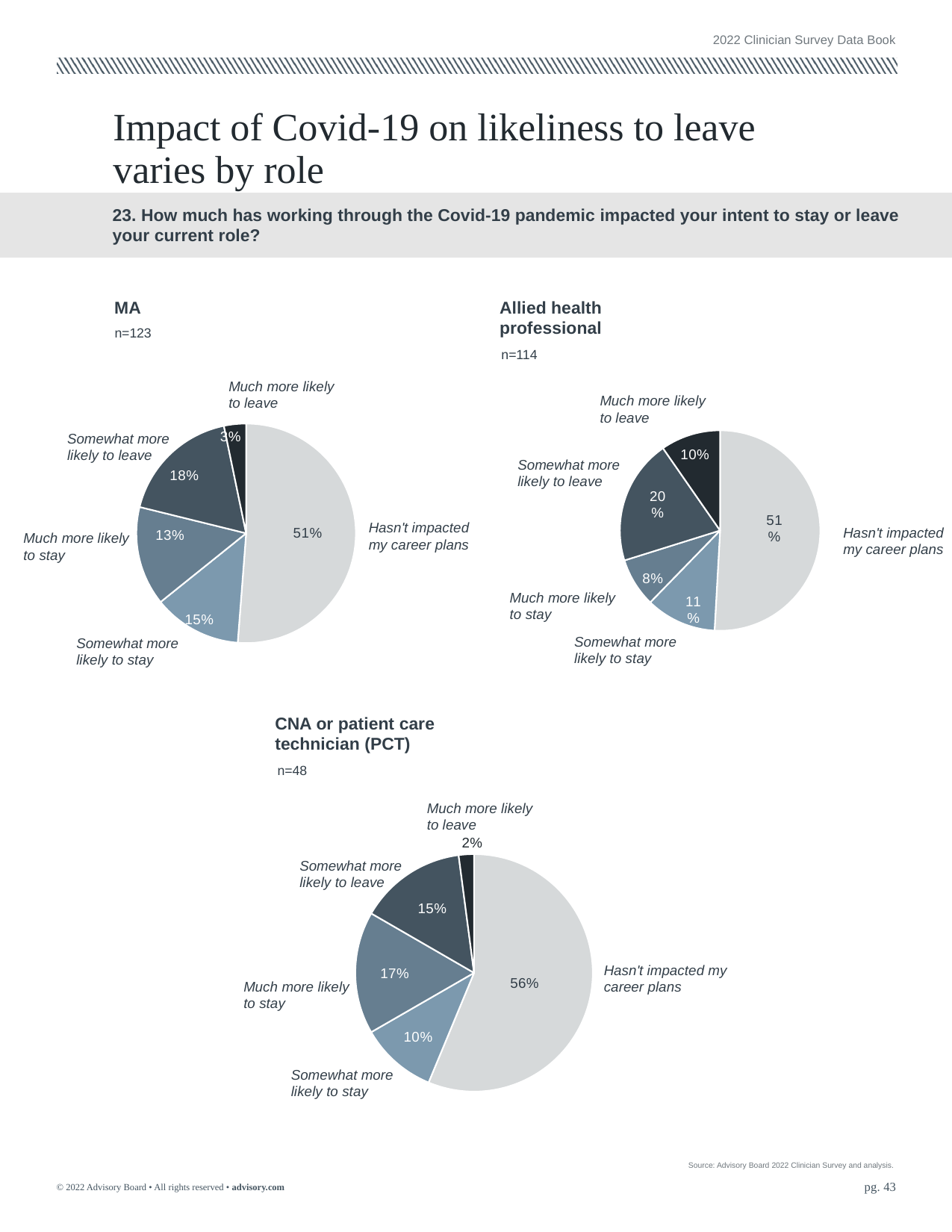
How many slices does the MA pie chart have? 5 In the Allied health professional chart, which category has the largest share? Hasn't impacted my career plans In the MA chart, what percentage of respondents said the pandemic hasn't impacted their career plans? 51% In the CNA or patient care technician (PCT) chart, what is the difference between the share much more likely to stay and the share somewhat more likely to stay? 7% In the Allied health professional chart, which is larger: the share somewhat more likely to stay or the share much more likely to stay? Somewhat more likely to stay In the MA chart, what percentage of respondents are somewhat more likely to leave? 18% In the Allied health professional chart, what percentage of respondents are much more likely to leave? 10% In the MA chart, what is the difference between the share somewhat more likely to leave and the share much more likely to leave? 15% In the CNA or patient care technician (PCT) chart, what percentage of respondents said the pandemic hasn't impacted their career plans? 56% In the CNA or patient care technician (PCT) chart, which category has the smallest share? Much more likely to leave What type of chart is used for the Allied health professional data? Pie chart What is the sample size (n) shown for the CNA or patient care technician (PCT) chart? n=48